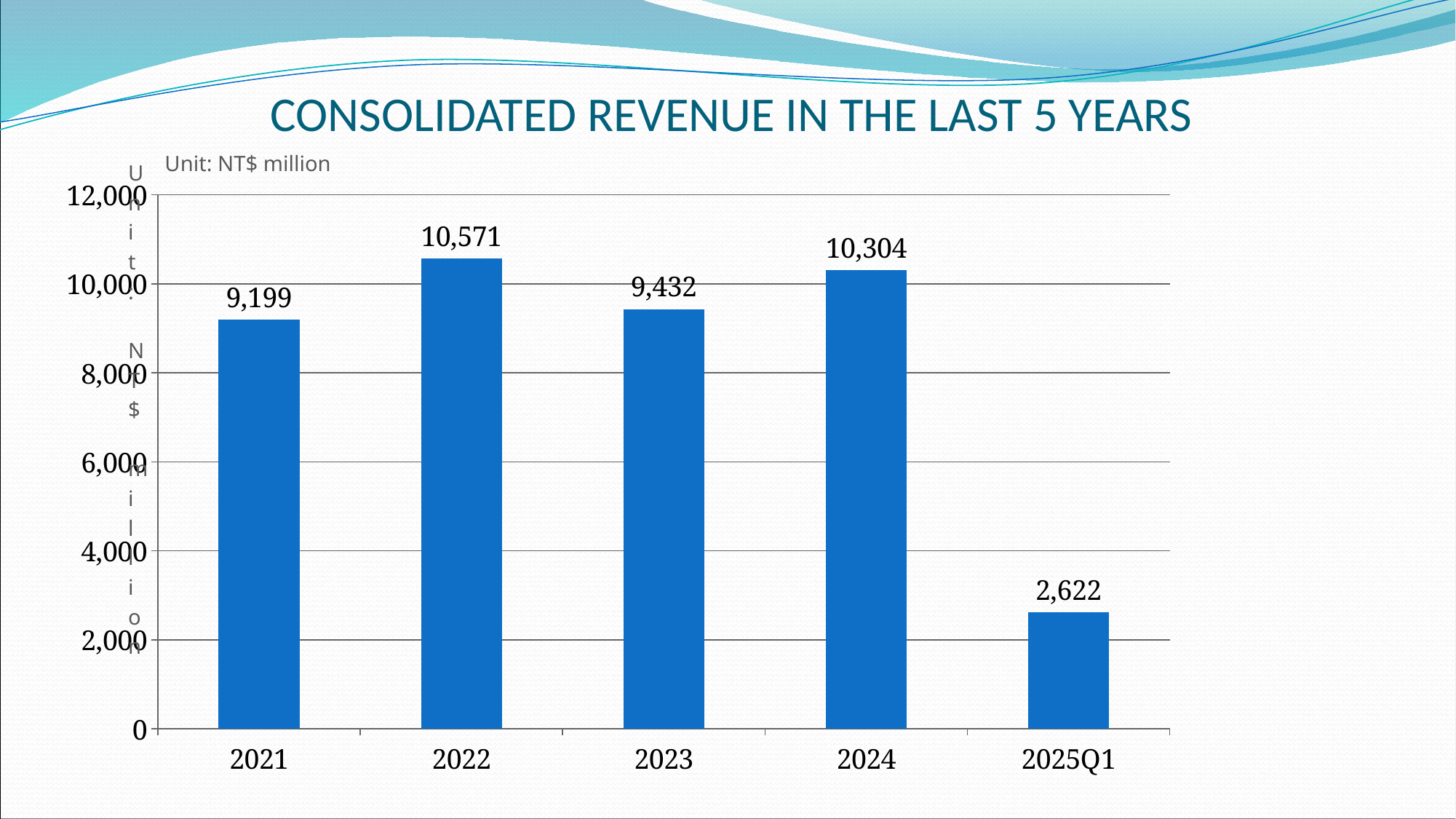
What is the difference between the revenue in 2022 and the revenue in 2023? 1,139 What is the difference between the revenue in 2024 and the revenue in 2021? 1,105 How many categories are shown on the x axis? 5 Is the value for 2024 greater or less than 10,000? greater Which is larger, the revenue in 2023 or the revenue in 2021? 2023 What is the consolidated revenue for 2022? 10,571 What is the consolidated revenue for 2021? 9,199 Which category has the lowest consolidated revenue? 2025Q1 What kind of chart is shown on the slide? bar chart What is the consolidated revenue for 2025Q1? 2,622 What unit is stated for the values in the chart? NT$ million Which year has the highest consolidated revenue? 2022